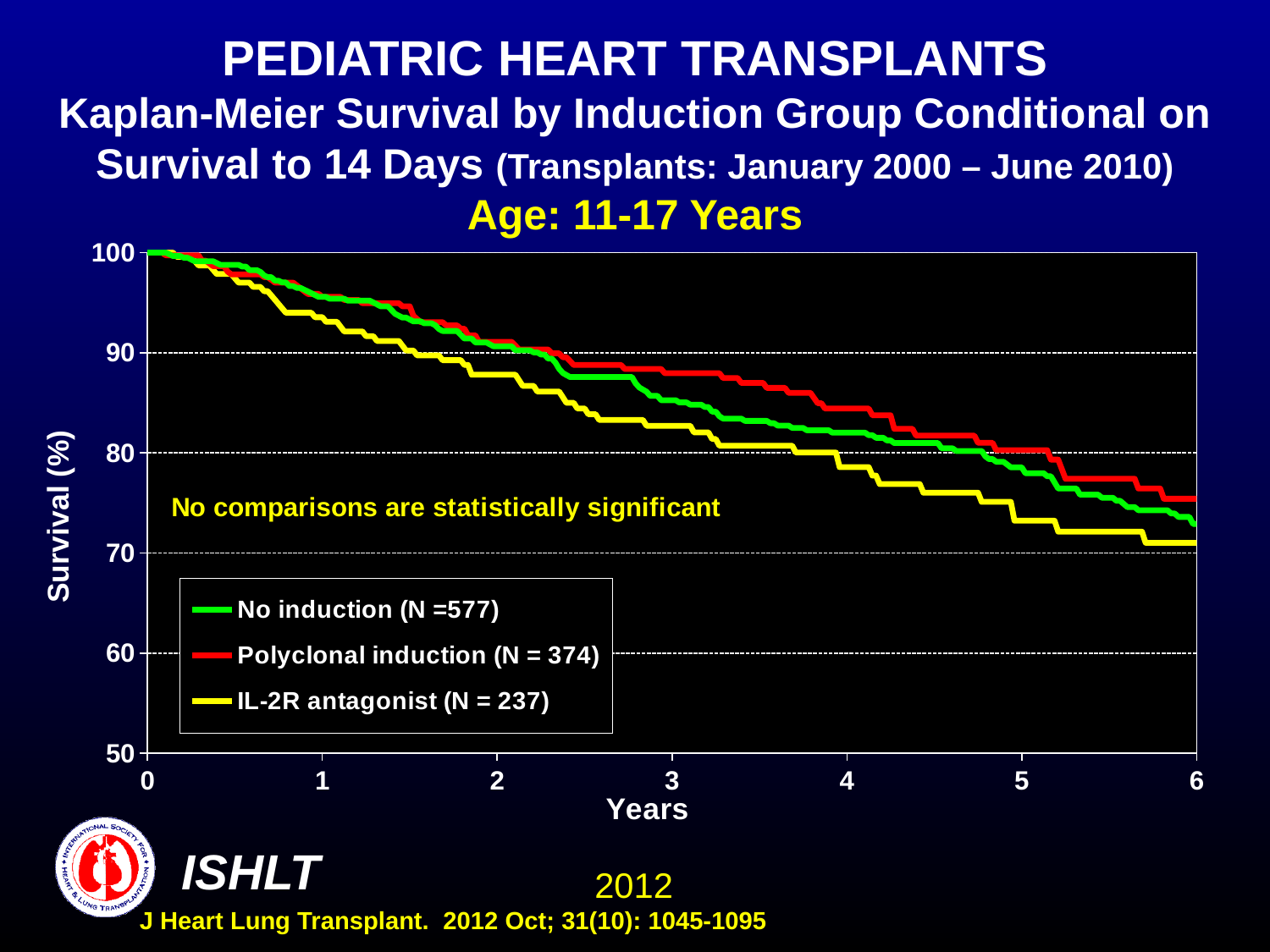
Which induction group has the highest survival at 6 years? Polyclonal induction Which induction group has the lowest survival at 6 years? IL-2R antagonist Do the survival curves rise or fall as years since transplant increase? Fall Is the survival for the Polyclonal induction group at 6 years greater or less than 80? less Is the survival for the Polyclonal induction group at 4 years greater or less than 80? greater Is the survival for the IL-2R antagonist group at 5 years greater or less than 80? less According to the legend, how many patients are in the No induction group? 577 How many series does the legend list? 3 At 5 years, is survival higher for the Polyclonal induction group or the IL-2R antagonist group? Polyclonal induction What kind of chart is shown on the slide? Line chart What is the survival value for all three groups at year 0? 100